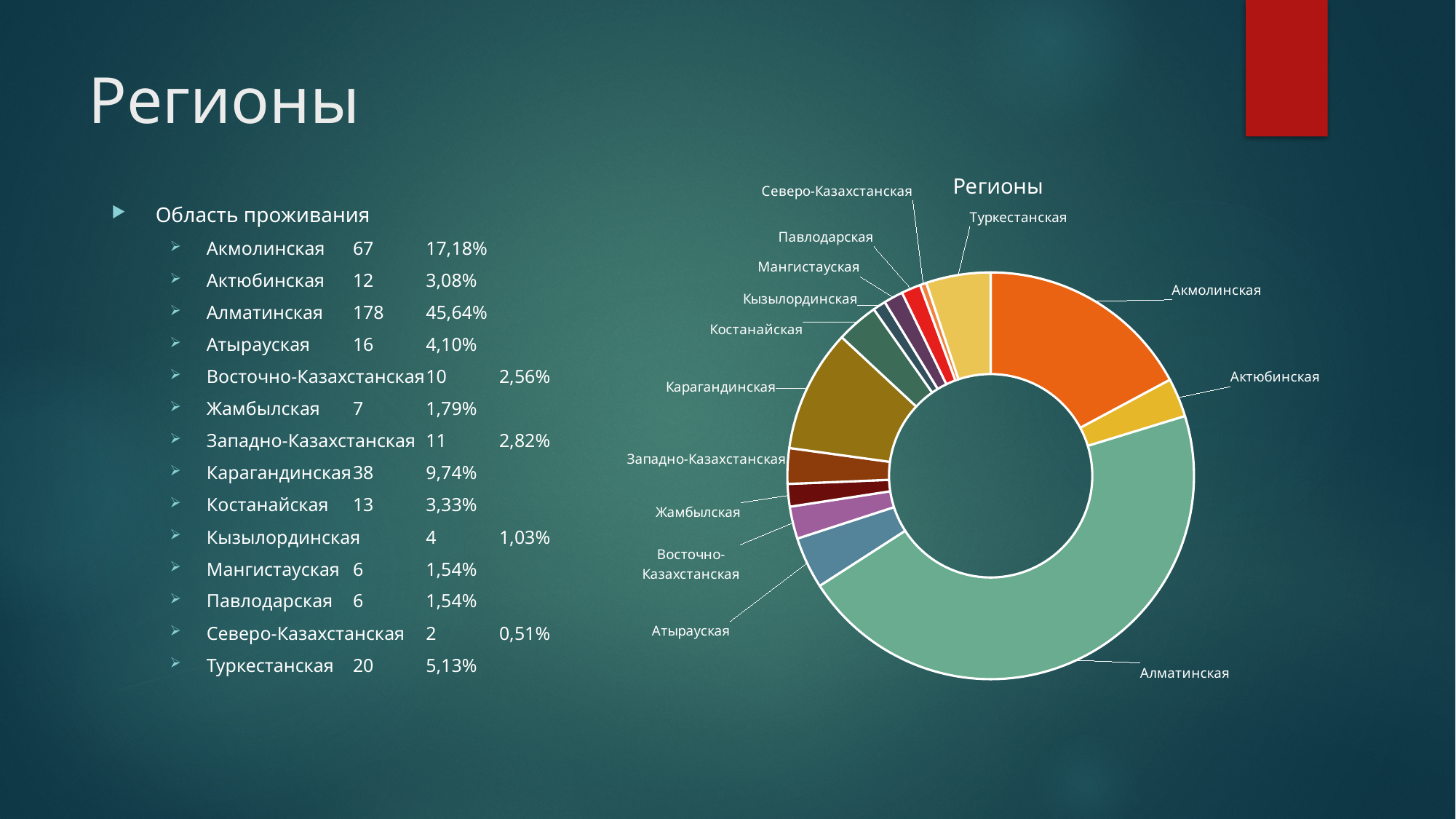
What is the value for Туркестанская? 20 What is the title of the chart? Регионы What share of the chart does Акмолинская account for? 17,18% Which region has the smallest slice in the chart? Северо-Казахстанская What is the value for Карагандинская? 38 What kind of chart is shown on the slide? Doughnut (pie) chart What share of the chart does Алматинская account for? 45,64% Which slice is larger, Атырауская or Жамбылская? Атырауская Which slice is larger, Акмолинская or Карагандинская? Акмолинская What is the difference between the values for Алматинская and Акмолинская? 111 Which region has the largest slice in the chart? Алматинская How many regions (slices) does the chart show? 14